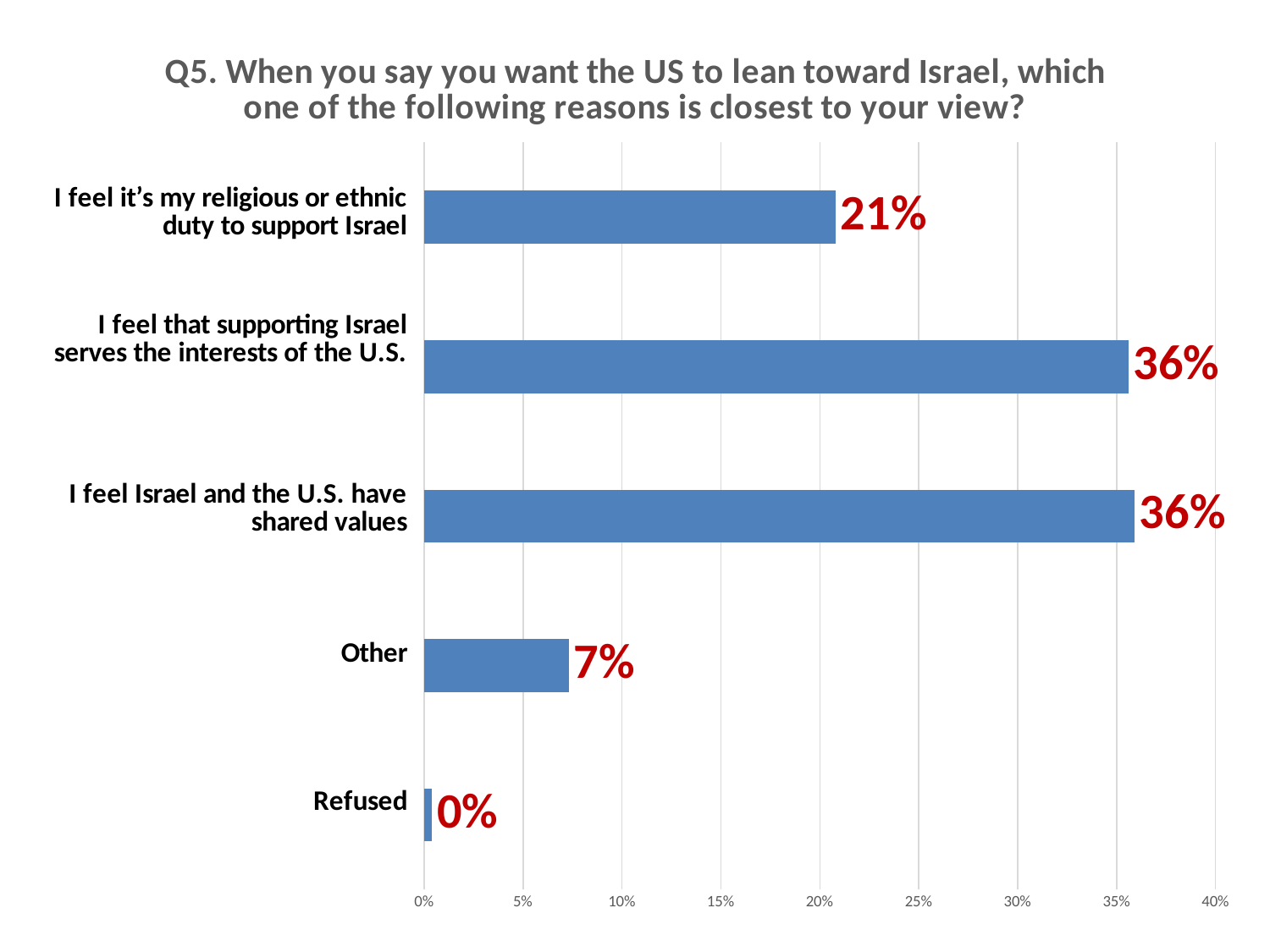
What type of chart is shown on the slide? Bar chart Which is larger: the value for 'Other' or the value for 'I feel it's my religious or ethnic duty to support Israel'? I feel it's my religious or ethnic duty to support Israel How many categories are shown in the chart? 5 What is the maximum value shown on the x axis? 40% What is the value shown for 'Refused'? 0% What is the value for 'I feel that supporting Israel serves the interests of the U.S.'? 36% What percentage of respondents said they feel it's their religious or ethnic duty to support Israel? 21% What is the difference between 'supporting Israel serves the interests of the U.S.' and 'religious or ethnic duty to support Israel'? 15 percentage points What is the difference between the 'religious or ethnic duty' value and the 'Other' value? 14 percentage points What percentage of respondents chose 'Other'? 7% Which category has the lowest value? Refused What is the value for 'I feel Israel and the U.S. have shared values'? 36%